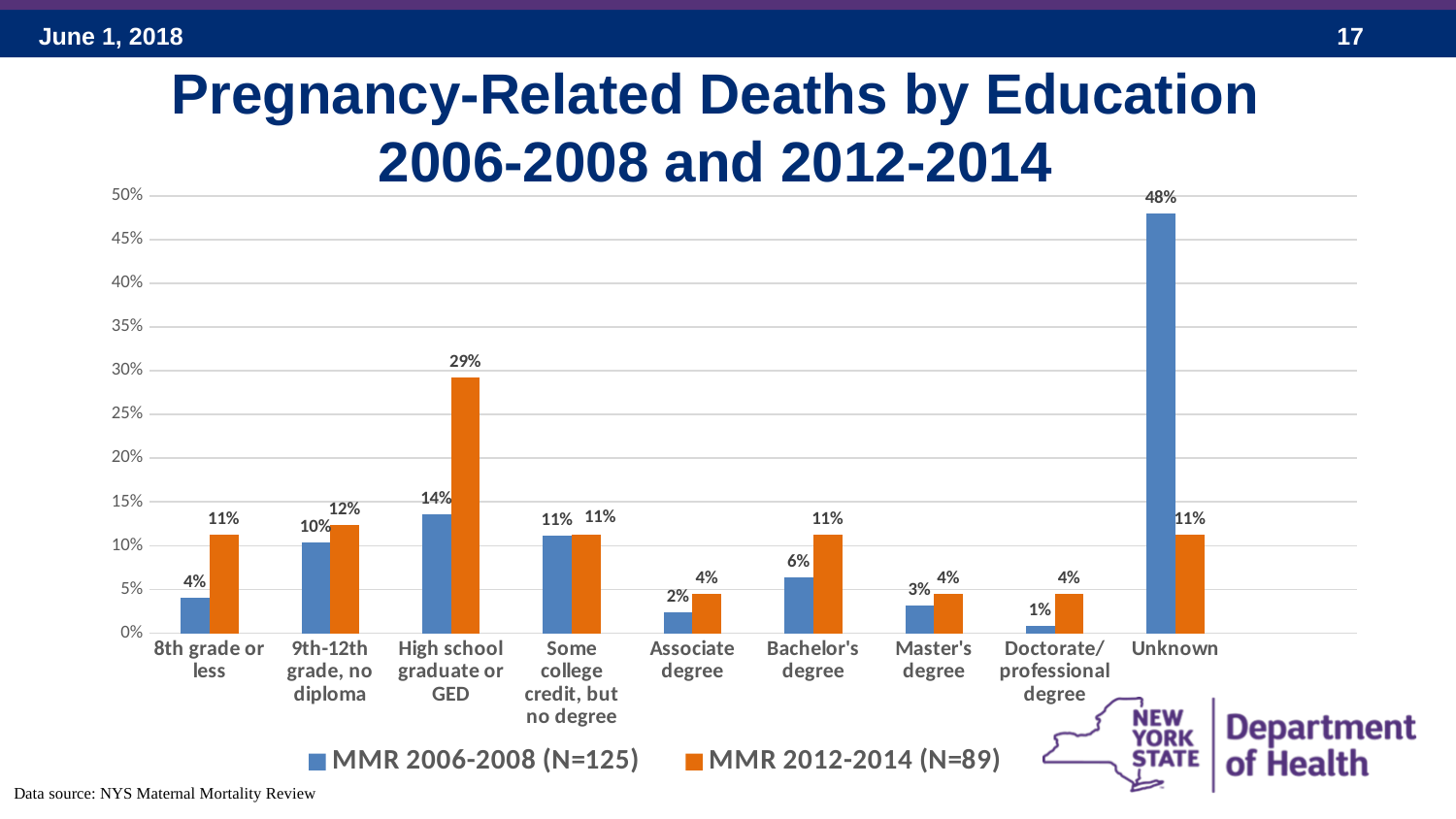
Which category has the highest value in the MMR 2006-2008 (N=125) series? Unknown For 8th grade or less, which series has the larger value, MMR 2006-2008 or MMR 2012-2014? MMR 2012-2014 What is the difference between the MMR 2012-2014 and MMR 2006-2008 values for High school graduate or GED? 15% Which category has the lowest value in the MMR 2006-2008 (N=125) series? Doctorate/professional degree How many series does the legend list? 2 What is the value for High school graduate or GED in the MMR 2012-2014 (N=89) series? 29% What kind of chart is shown on the slide? Bar chart What is the value for Doctorate/professional degree in the MMR 2012-2014 (N=89) series? 4% What is the value for Bachelor's degree in the MMR 2006-2008 (N=125) series? 6% What is the value for Unknown in the MMR 2006-2008 (N=125) series? 48% Which category has the highest value in the MMR 2012-2014 (N=89) series? High school graduate or GED How many education categories are shown on the x axis? 9